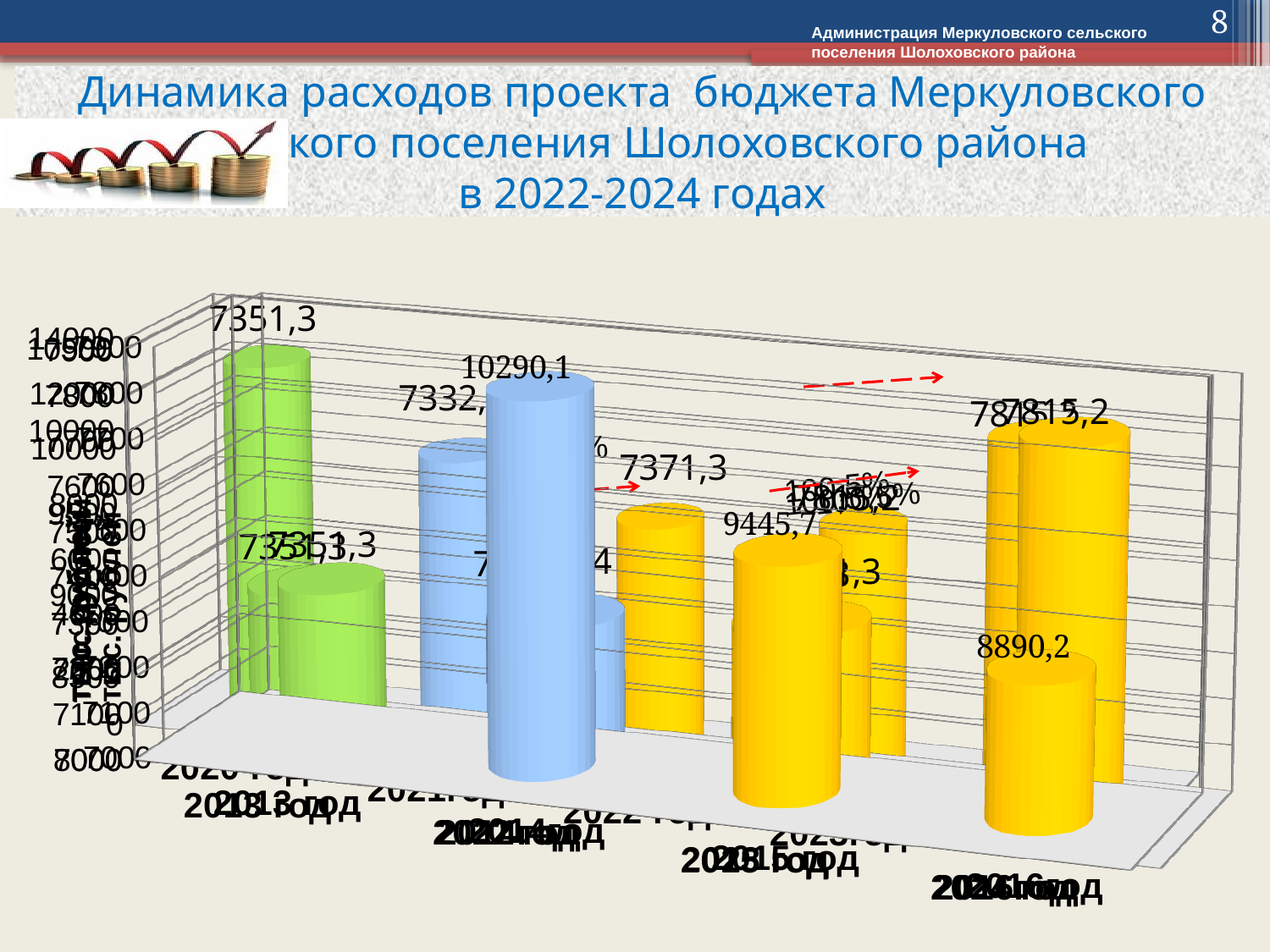
What is the difference between the values 10290,1 and 9445,7 printed on the chart? 844,4 What value is printed above the tallest blue bar? 10290,1 What colours are the bars on the chart? green, blue and yellow What value is printed above the tallest green bar at the left of the chart? 7351,3 What is the largest value printed as a data label on the chart? 10290,1 What is the difference between the values 9445,7 and 8890,2 printed on the chart? 555,5 What kind of chart is shown on the slide? bar chart According to the slide title, which years does the chart of budget expenditure dynamics cover? 2022-2024 What value is printed above the front yellow bar labelled 9445,7 or 8890,2 that is furthest to the right? 8890,2 Which is larger, the bar labelled 10290,1 or the bar labelled 9445,7? 10290,1 Which is larger, the bar labelled 9445,7 or the bar labelled 8890,2? 9445,7 Which is larger, the bar labelled 7371,3 or the bar labelled 7351,3? 7371,3